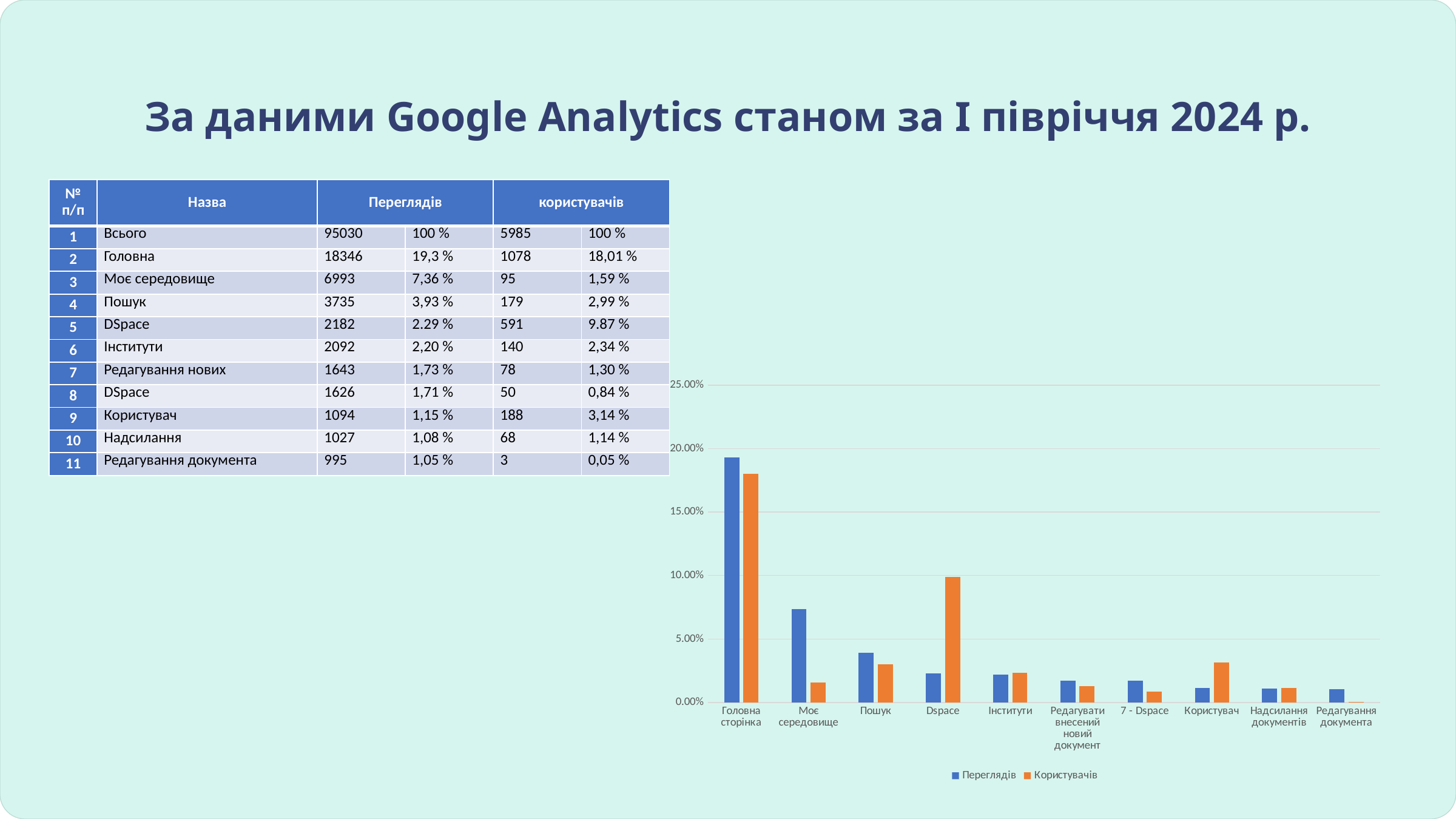
For Моє середовище, which series has the larger bar, Переглядів or Користувачів? Переглядів Which category has the lowest Користувачів bar in the chart? Редагування документа Which category has the highest Користувачів bar in the chart? Головна сторінка Which category has the highest Переглядів bar in the chart? Головна сторінка Is the Переглядів value for Головна сторінка greater or less than 15.00%? greater How many categories are shown along the x axis of the chart? 10 What kind of chart is shown on the slide? bar chart Do the Переглядів bars generally rise or fall from left to right along the x axis? fall Is the Переглядів value for Моє середовище greater or less than 5.00%? greater For Dspace, which series has the larger bar, Переглядів or Користувачів? Користувачів How many series does the chart legend list? 2